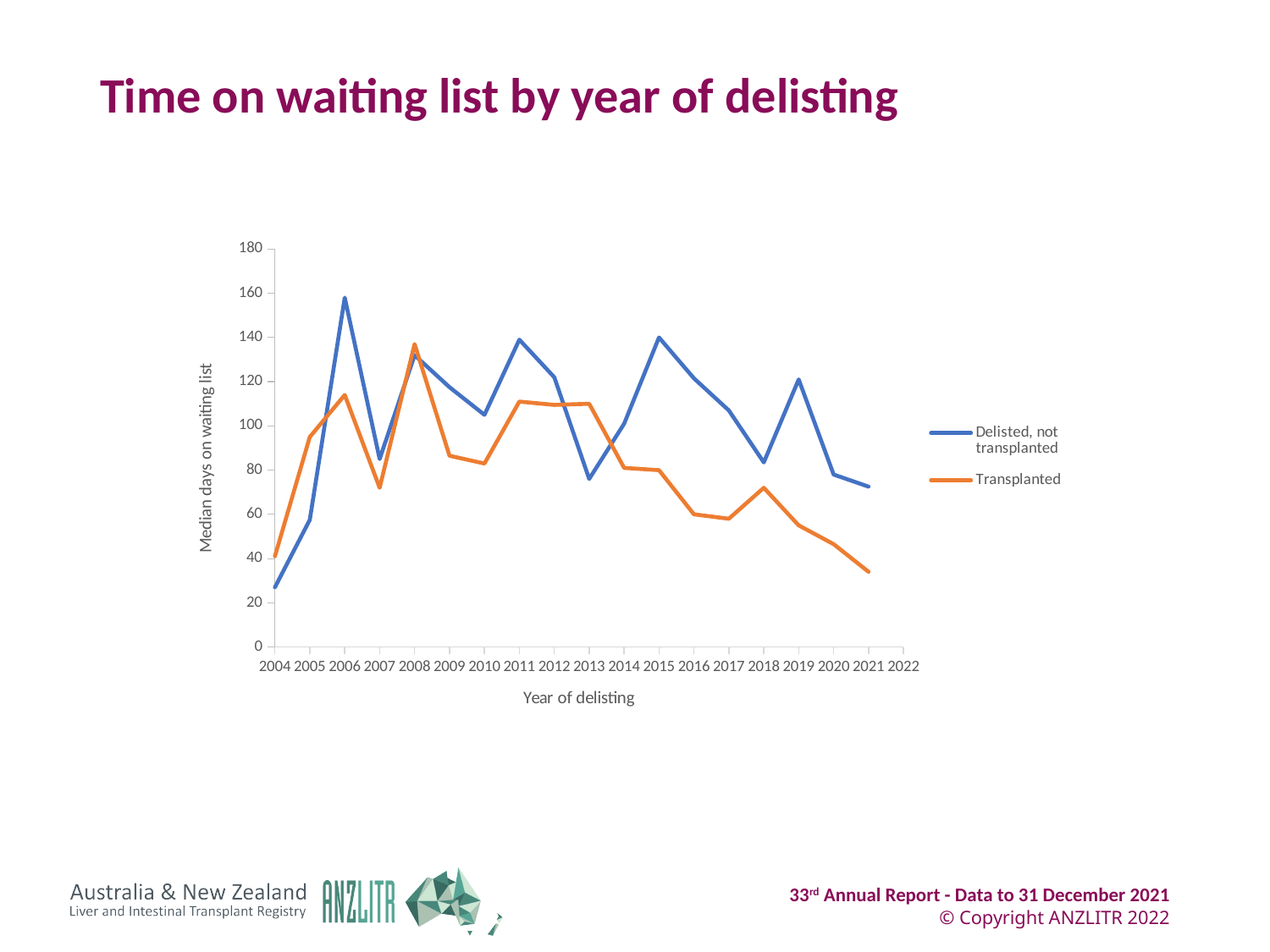
In which year of delisting is the 'Transplanted' series at its lowest? 2021 Is the value for 'Transplanted' in 2016 greater or less than 80? less In which year of delisting does the 'Delisted, not transplanted' series reach its highest median days on waiting list? 2006 Is the value for 'Delisted, not transplanted' in 2006 greater or less than 140? greater Does the 'Transplanted' series generally rise or fall from 2013 to 2021? Fall In which year of delisting does the 'Transplanted' series reach its highest median days on waiting list? 2008 What kind of chart is shown on the slide? Line chart Is the value for 'Transplanted' in 2021 greater or less than 40? less In 2013, which series has the higher median days on waiting list, 'Delisted, not transplanted' or 'Transplanted'? Transplanted In which year of delisting is the 'Delisted, not transplanted' series at its lowest? 2004 How many series does the legend list? 2 In 2019, which series has the higher median days on waiting list, 'Delisted, not transplanted' or 'Transplanted'? Delisted, not transplanted